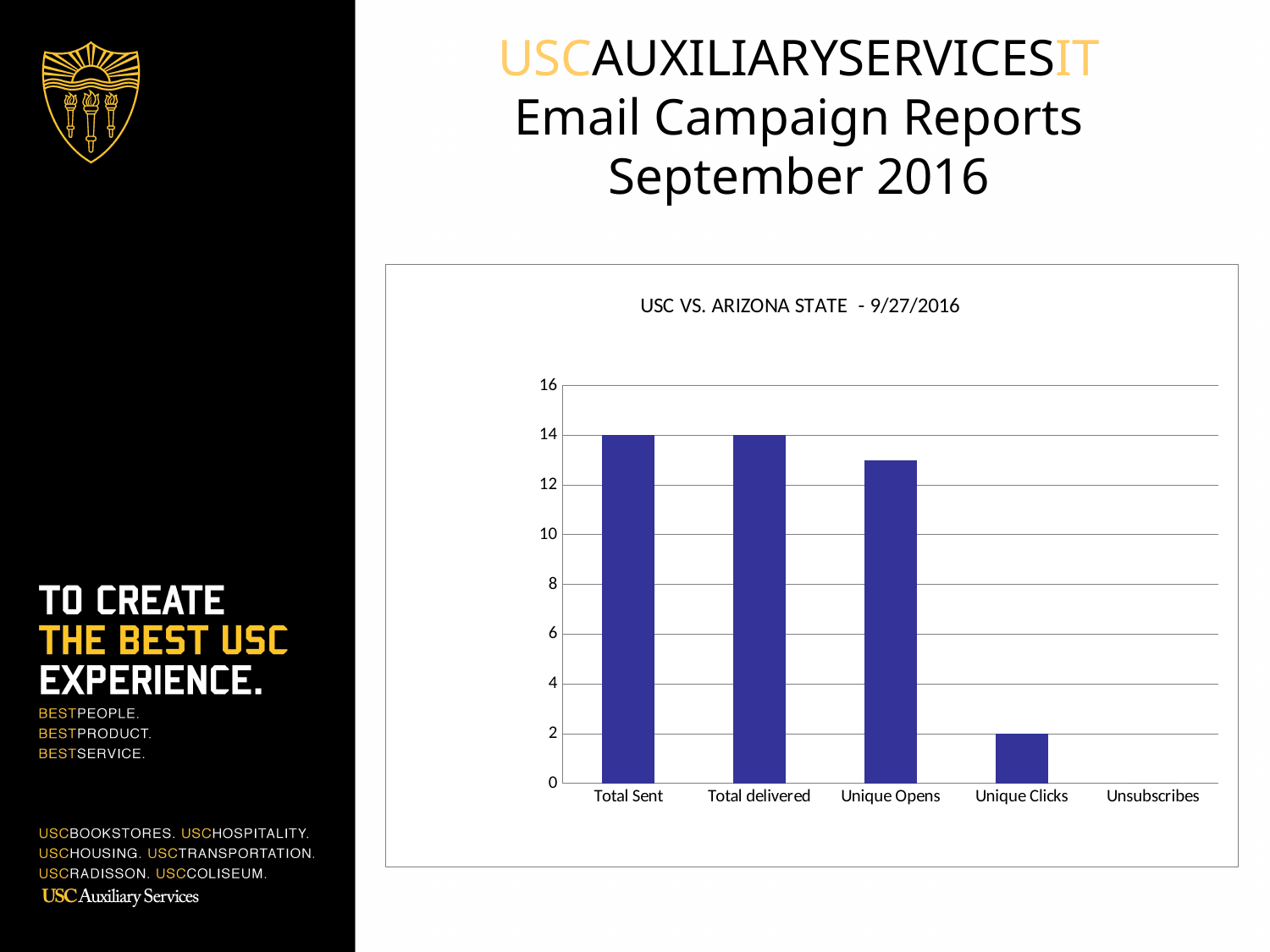
Is the value for Unique Opens greater or less than 12? greater What is the value for Unsubscribes? 0 Is the value for Unique Opens greater or less than 14? less What is the title of the chart? USC VS. ARIZONA STATE - 9/27/2016 What type of chart is shown on the slide? bar chart What is the value for Total Sent? 14 Which is larger, the value for Unique Opens or the value for Unique Clicks? Unique Opens What is the difference between the values for Total Sent and Unique Clicks? 12 Which category has the lowest value? Unsubscribes What is the value for Unique Clicks? 2 What is the value for Total delivered? 14 How many categories are shown on the x axis of the chart? 5